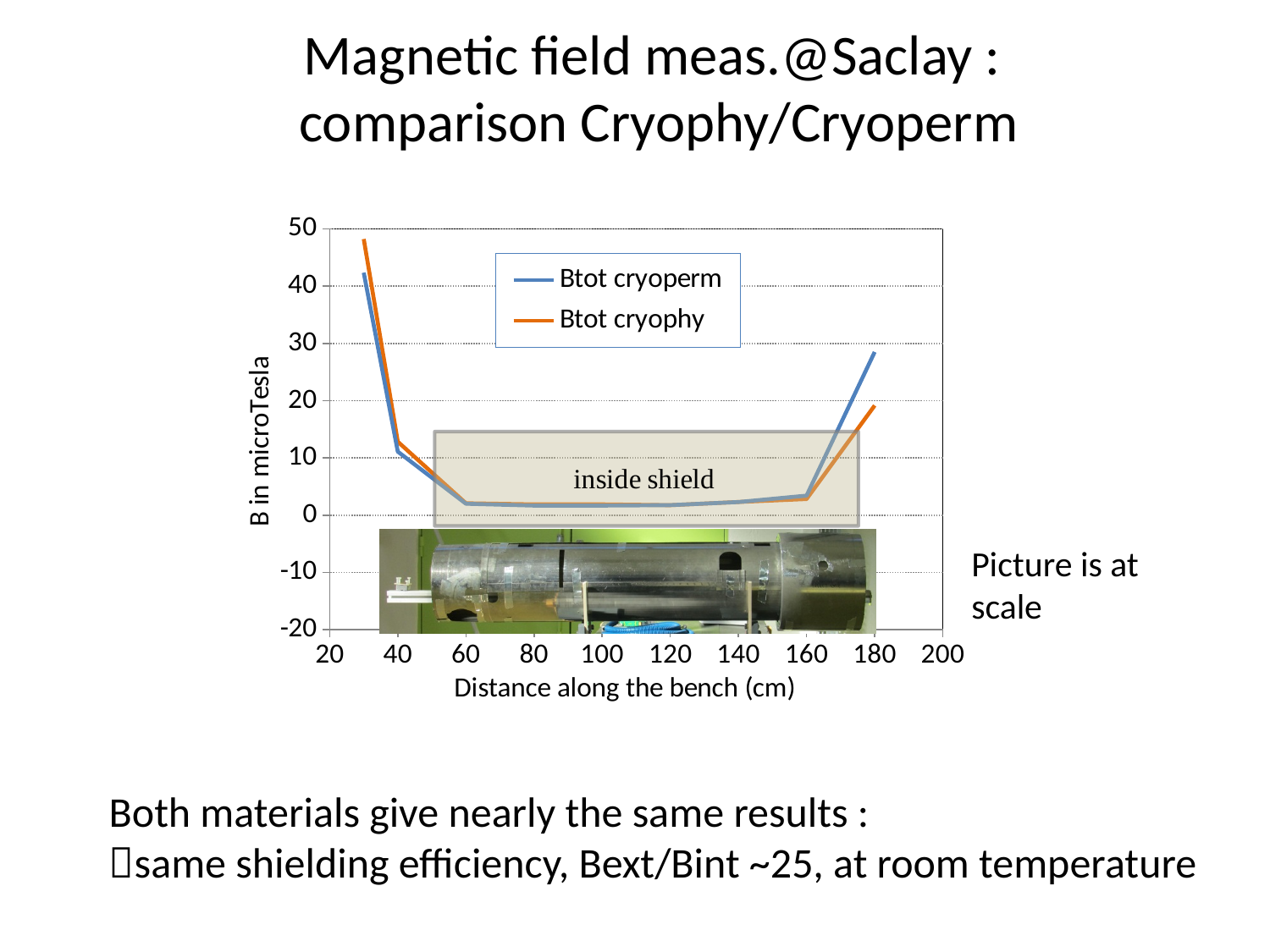
At 180 cm, which series has the higher value, Btot cryoperm or Btot cryophy? Btot cryoperm Is the value of Btot cryoperm at 180 cm greater or less than 20 microTesla? greater What is the label of the x axis of the chart? Distance along the bench (cm) Is the value of Btot cryoperm at 100 cm greater or less than 10 microTesla? less Do the values of Btot cryoperm rise or fall between 30 cm and 60 cm? fall Is the value of Btot cryophy at 30 cm greater or less than 40 microTesla? greater What are the two series named in the chart legend? Btot cryoperm and Btot cryophy How many series does the chart legend list? 2 At 30 cm, which series has the higher value, Btot cryoperm or Btot cryophy? Btot cryophy What kind of chart is shown on the slide? line chart Do the values of Btot cryophy rise or fall between 160 cm and 180 cm? rise